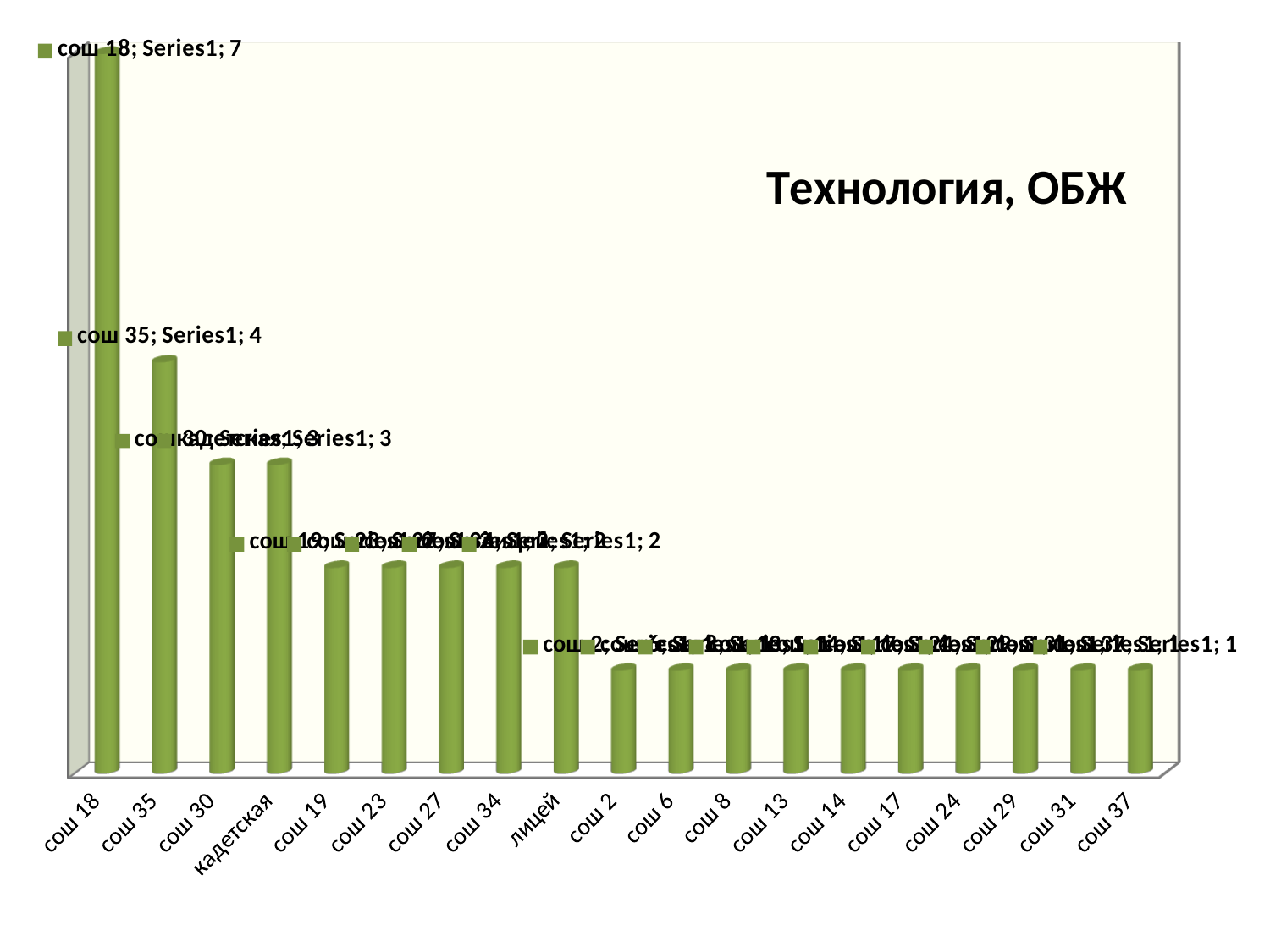
What is the value for сош 18? 7 What is the value for сош 35? 4 How many categories are shown on the x axis of the chart? 19 What is the value for сош 30? 3 Do the values rise or fall from left to right along the x axis? fall What is the value for сош 37? 1 What kind of chart is shown on the slide? bar chart Which category has the highest value? сош 18 What is the name of the data series shown in the data labels? Series1 What is the difference between the values for сош 18 and сош 35? 3 Which has a larger value, сош 35 or сош 19? сош 35 What is the title of the chart? Технология, ОБЖ